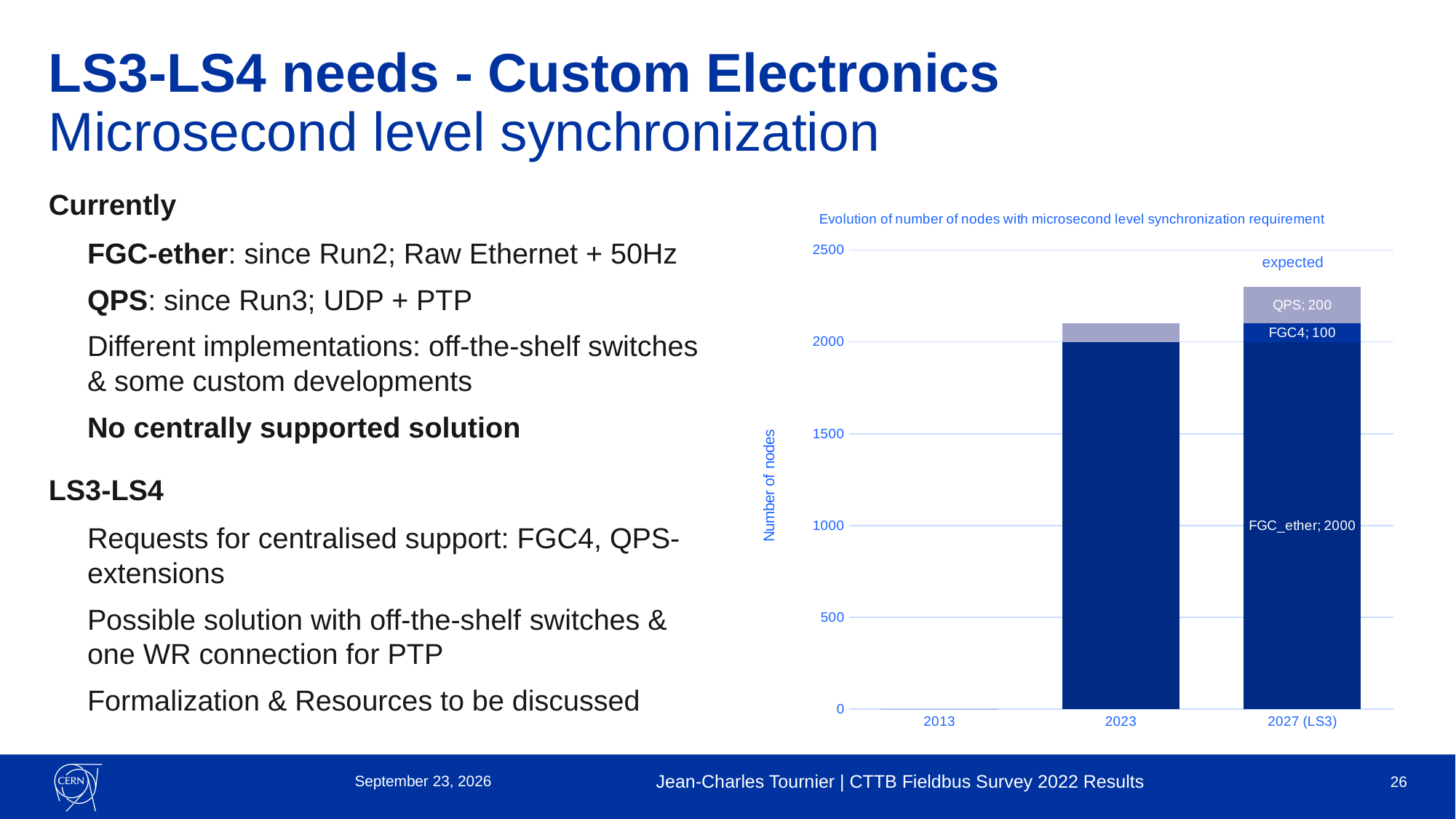
In the 2027 (LS3) bar, which is larger: the QPS segment or the FGC4 segment? QPS What is the label of the y axis of the chart? Number of nodes What is the value of the QPS segment for 2027 (LS3)? 200 Which year has the tallest bar in the chart? 2027 (LS3) What is the value of the FGC_ether segment for 2027 (LS3)? 2000 How many categories are shown on the x axis of the chart? 3 Is the total value of the bar for 2023 greater or less than 2000? greater What is the total number of nodes in the stacked bar for 2027 (LS3)? 2300 What kind of chart is shown on the slide? Stacked bar chart What is the value of the FGC4 segment for 2027 (LS3)? 100 Is the total value of the bar for 2023 greater or less than 2500? less In the 2027 (LS3) bar, what is the difference between the QPS segment and the FGC4 segment? 100